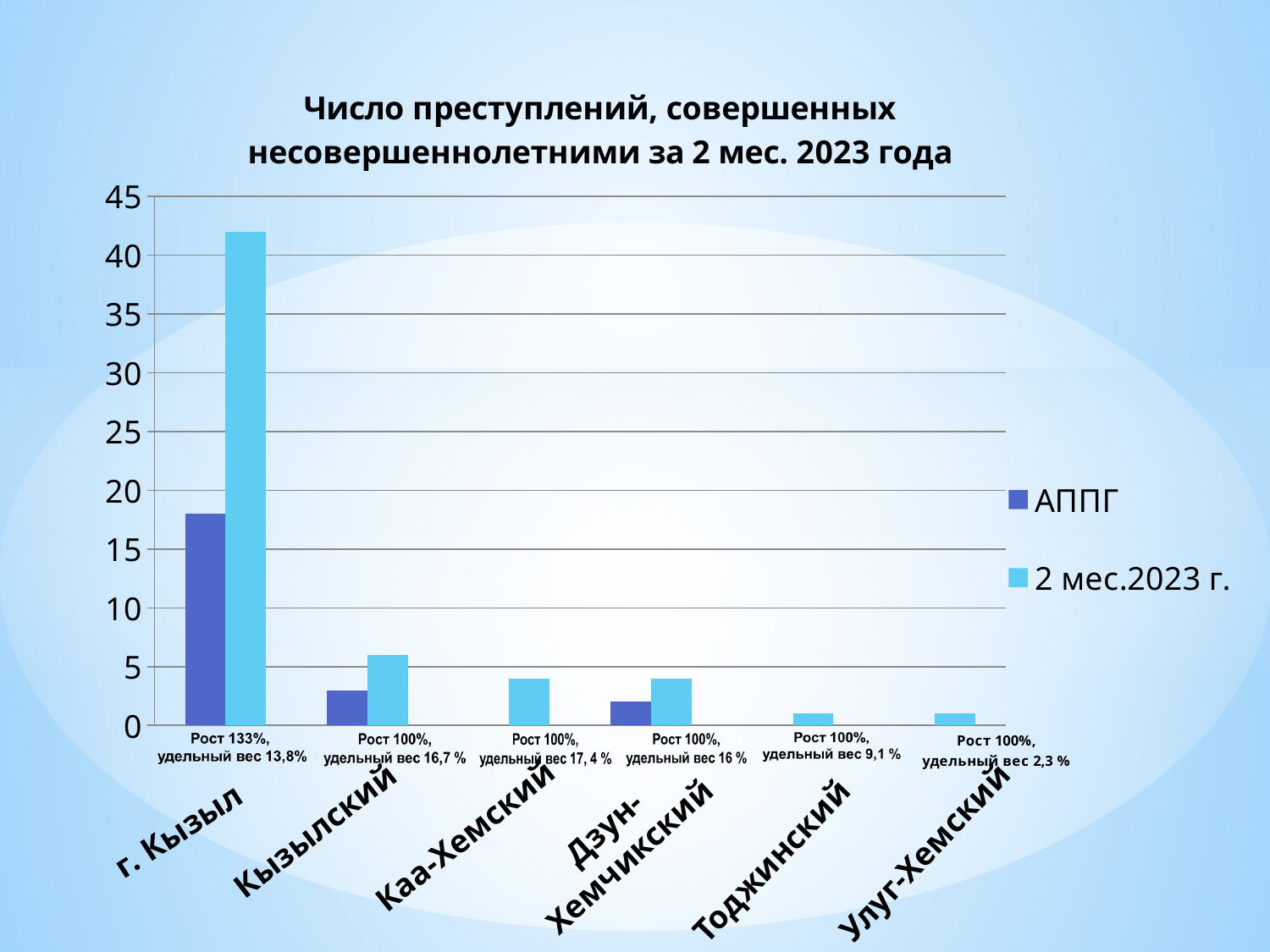
For г. Кызыл, which series has the larger value, АППГ or 2 мес.2023 г.? 2 мес.2023 г. How many categories (districts) are shown on the x axis? 6 What kind of chart is shown on the slide? bar chart Is the value for Кызылский in the series 2 мес.2023 г. greater or less than 5? greater How many series does the legend list? 2 Which category has the highest value for the series 2 мес.2023 г.? г. Кызыл What is the title of the chart? Число преступлений, совершенных несовершеннолетними за 2 мес. 2023 года Which category has the highest value for the series АППГ? г. Кызыл Is the value for г. Кызыл in the series АППГ greater or less than 20? less What growth percentage and share are printed under the г. Кызыл bars? Рост 133%, удельный вес 13,8% What share (удельный вес) is printed for Улуг-Хемский? 2,3 % Is the value for г. Кызыл in the series 2 мес.2023 г. greater or less than 40? greater